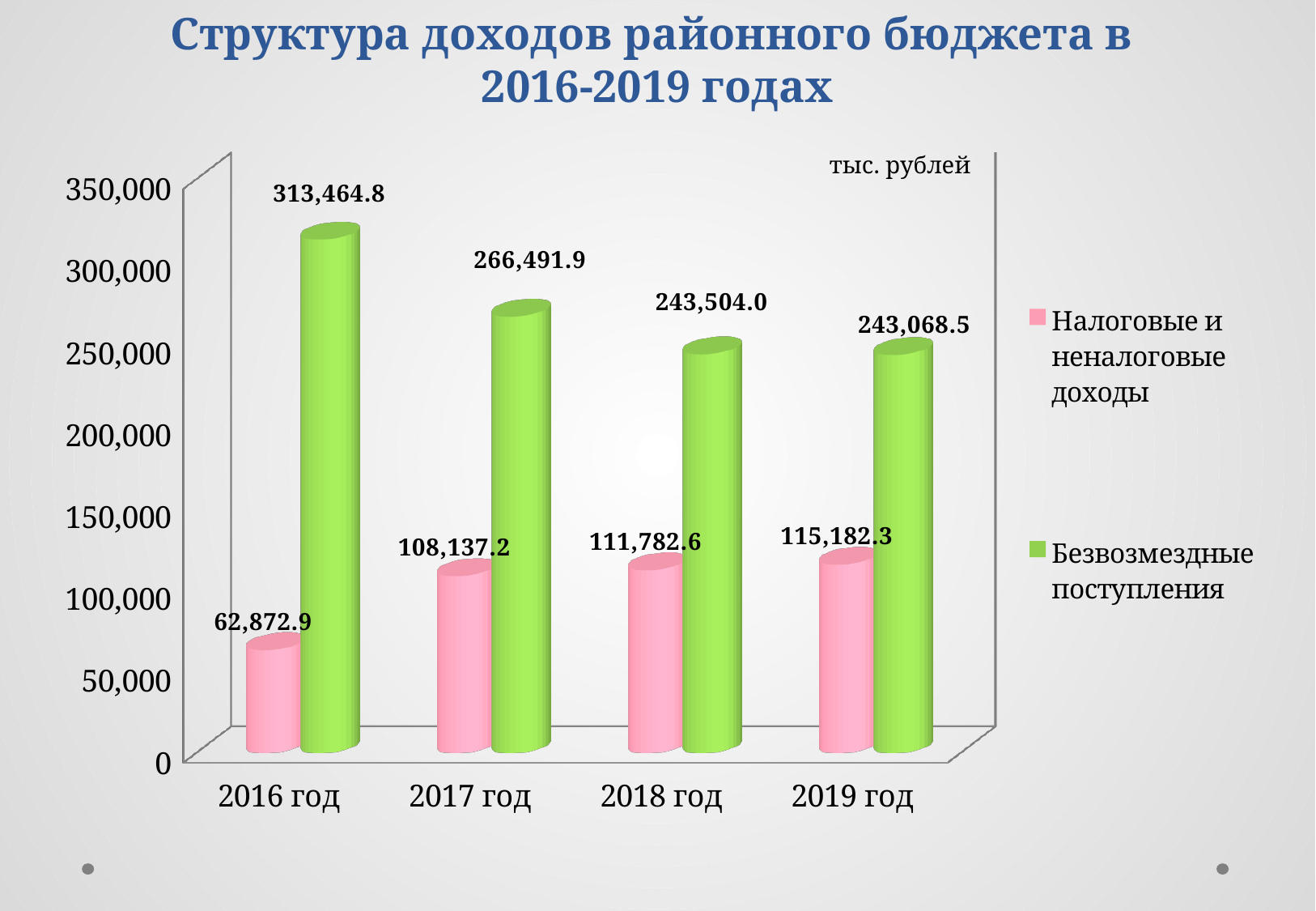
What is the value for Безвозмездные поступления in 2016 год? 313,464.8 In which year is Налоговые и неналоговые доходы lowest? 2016 год How many series does the legend list? 2 Do the values for Безвозмездные поступления rise or fall from 2016 год to 2019 год? Fall What is the value for Налоговые и неналоговые доходы in 2017 год? 108,137.2 Is the value for Безвозмездные поступления in 2017 год greater or less than 250,000? greater What is the difference between Безвозмездные поступления and Налоговые и неналоговые доходы in 2016 год? 250,591.9 Which is larger in 2018 год: Налоговые и неналоговые доходы or Безвозмездные поступления? Безвозмездные поступления How many years are shown on the x axis? 4 What kind of chart is shown on the slide? Bar chart What is the value for Налоговые и неналоговые доходы in 2019 год? 115,182.3 In which year is Безвозмездные поступления highest? 2016 год